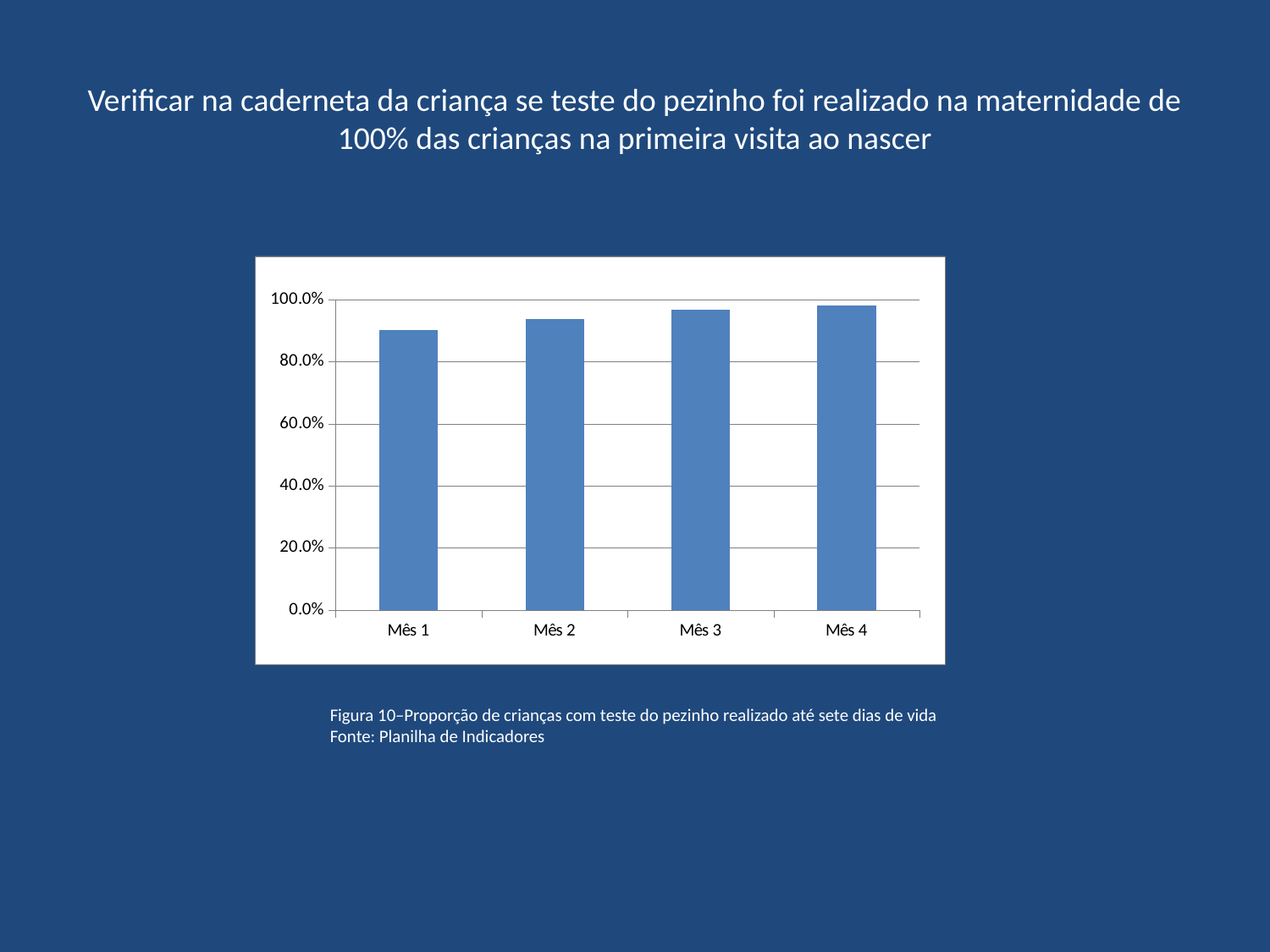
Is the value for Mês 1 greater or less than 80.0%? greater What kind of chart is shown on the slide? bar chart What is the figure number given in the caption below the chart? Figura 10 How many categories are shown on the x axis of the chart? 4 Which is larger, the value for Mês 1 or the value for Mês 4? Mês 4 Is the value for Mês 2 greater or less than 80.0%? greater What source is cited below the chart? Planilha de Indicadores Which month has the lowest bar in the chart? Mês 1 Do the values rise or fall from Mês 1 to Mês 4? rise Is the value for Mês 3 greater or less than 60.0%? greater Which is larger, the value for Mês 1 or the value for Mês 2? Mês 2